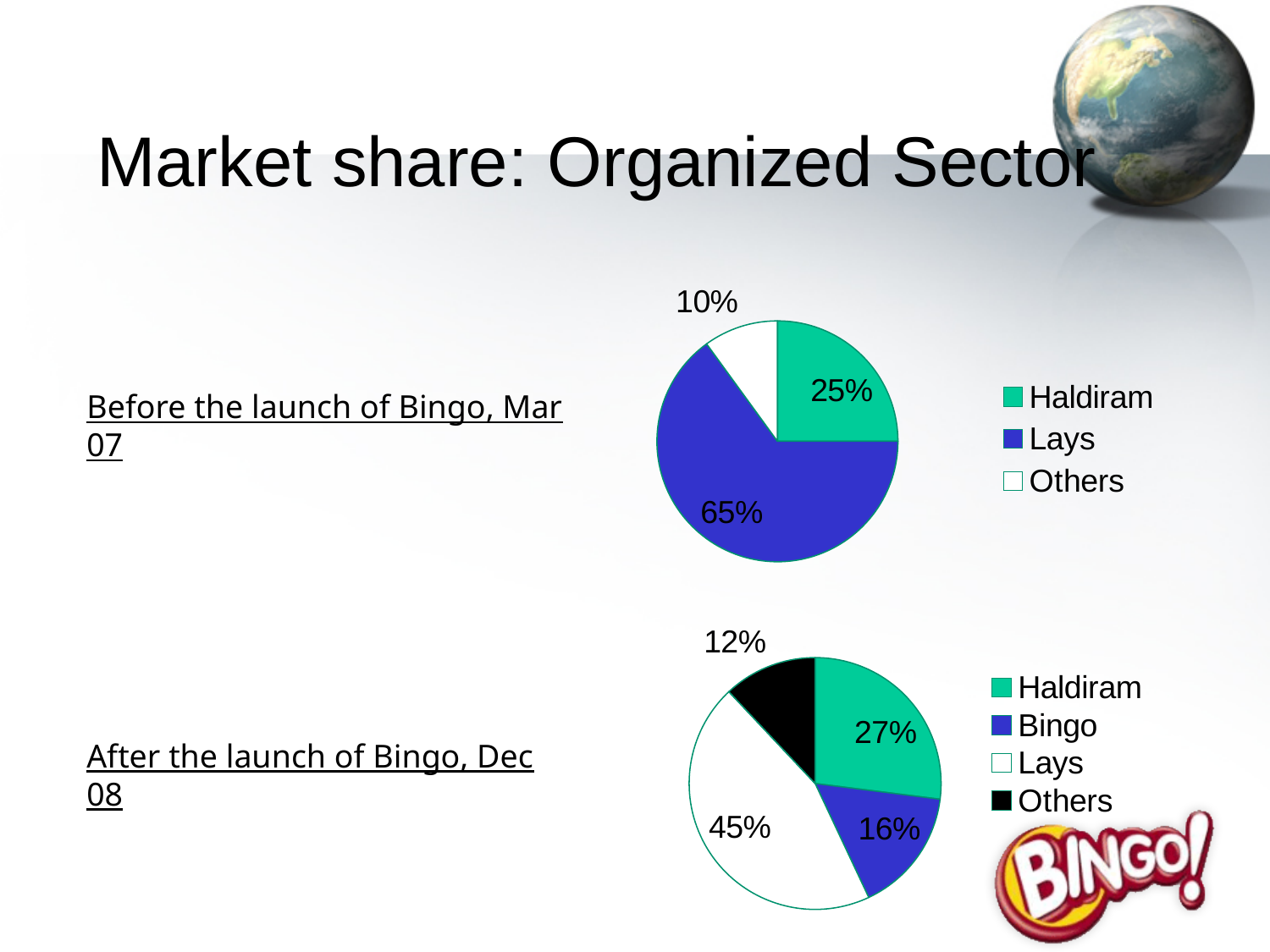
In the bottom pie chart (After the launch of Bingo, Dec 08), which category has the smallest share? Others In the bottom pie chart (After the launch of Bingo, Dec 08), what share does Bingo hold? 16% In the bottom pie chart (After the launch of Bingo, Dec 08), what colour represents Others? Black In the top pie chart (Before the launch of Bingo, Mar 07), what share does Lays hold? 65% In the bottom pie chart (After the launch of Bingo, Dec 08), what is the difference between the Lays share and the Haldiram share? 18% In the bottom pie chart (After the launch of Bingo, Dec 08), which is larger, the Haldiram share or the Bingo share? Haldiram How many categories does the legend of the top pie chart (Before the launch of Bingo, Mar 07) list? 3 In the bottom pie chart (After the launch of Bingo, Dec 08), what share does Lays hold? 45% How many categories does the legend of the bottom pie chart (After the launch of Bingo, Dec 08) list? 4 In the top pie chart (Before the launch of Bingo, Mar 07), what share does Haldiram hold? 25% In the top pie chart (Before the launch of Bingo, Mar 07), which category has the largest share? Lays What type of chart is used for the market share before the launch of Bingo? Pie chart